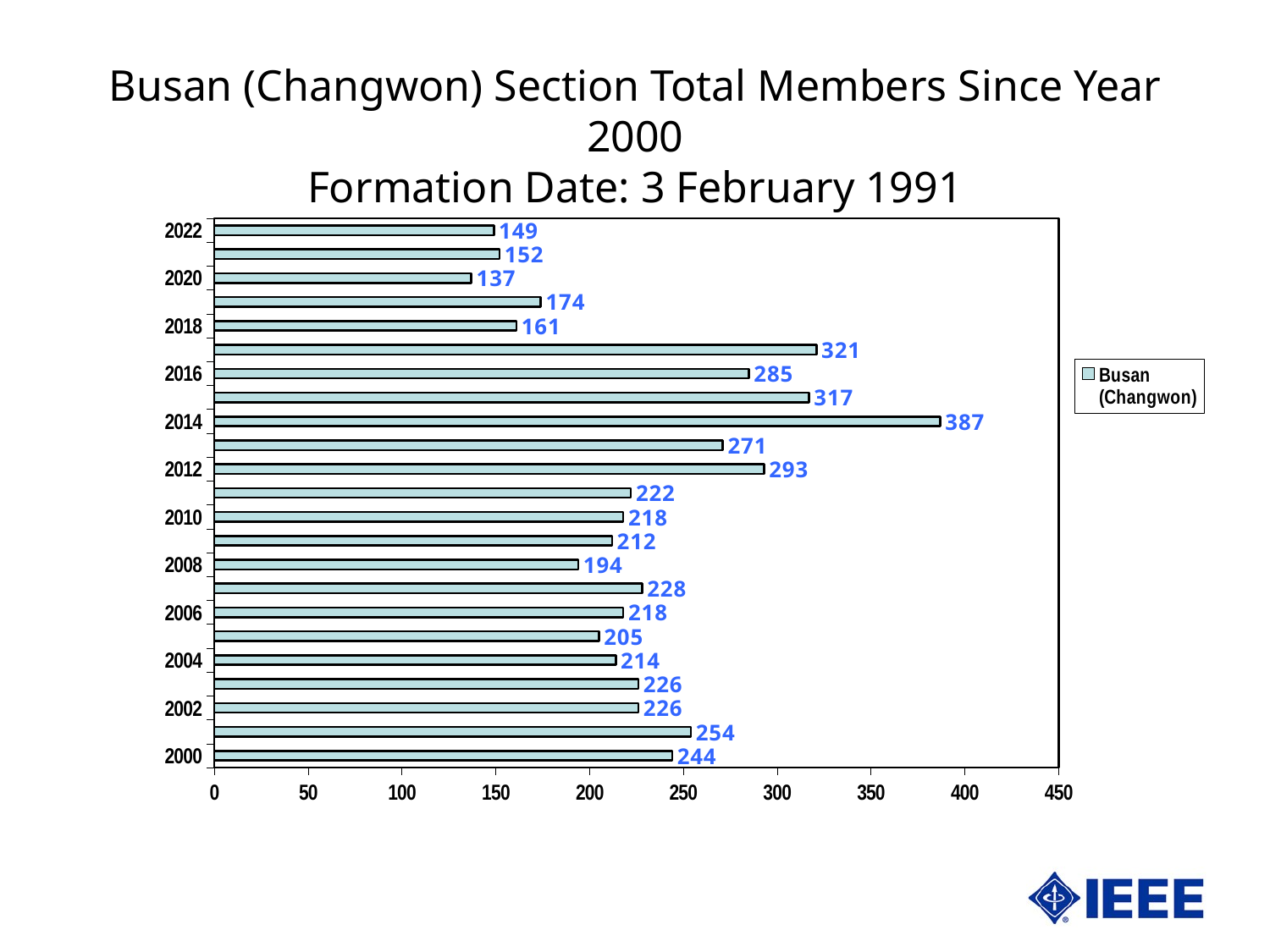
Which year has the lowest number of members? 2020 What is the difference in members between 2014 and 2022? 238 What is the total number of members for 2000? 244 What is the total number of members for 2014? 387 How many series does the legend list? 1 What is the total number of members for 2020? 137 Which year has the highest number of members? 2014 What is the name of the series shown in the legend? Busan (Changwon) Which year has more members, 2018 or 2008? 2008 How many bars are plotted in the chart? 23 What is the total number of members for 2016? 285 What type of chart is shown on the slide? bar chart